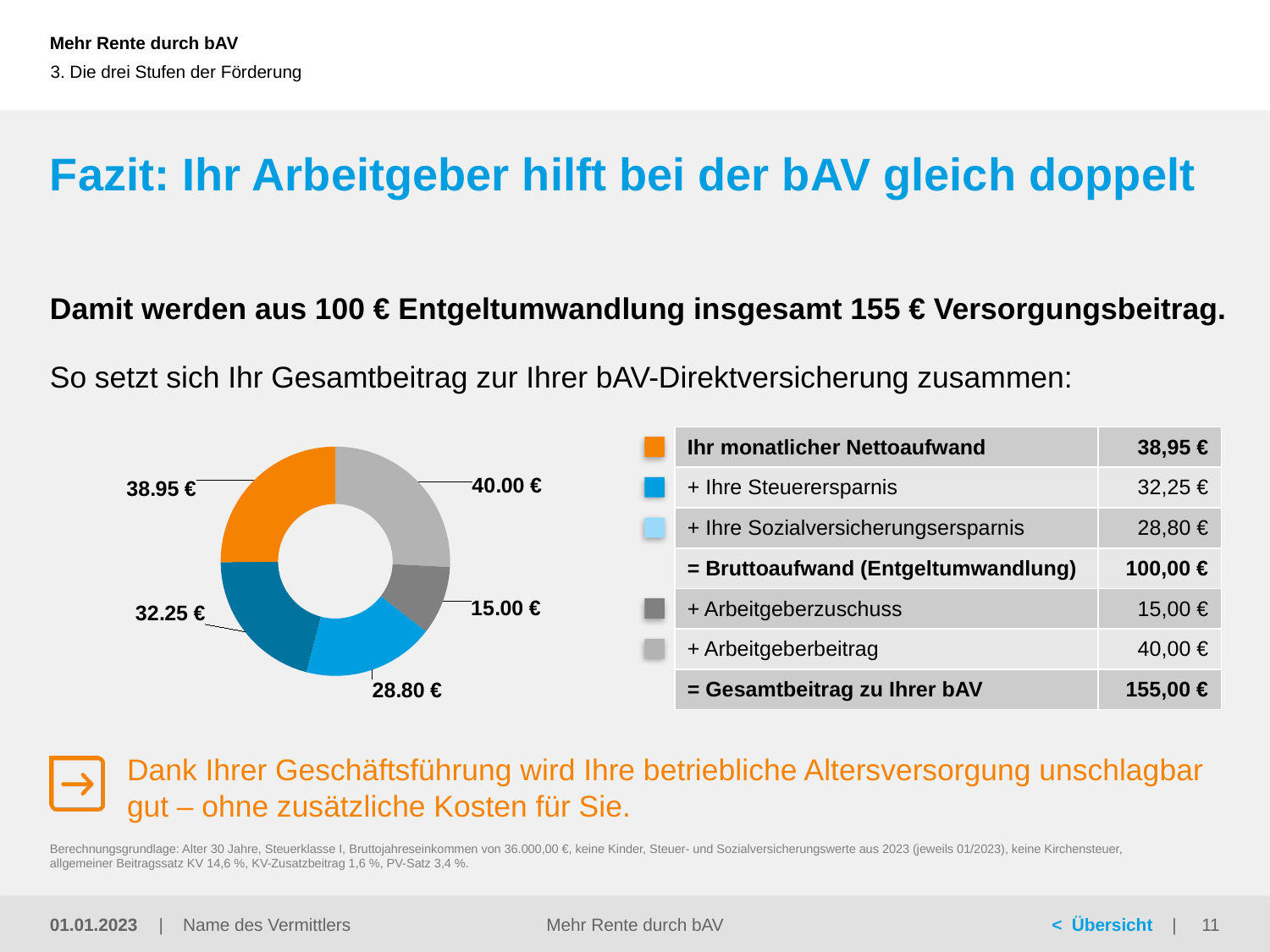
Which slice of the donut chart has the largest value? Arbeitgeberbeitrag (40.00 €) What colour is the slice representing Ihr monatlicher Nettoaufwand? Orange What value is shown for the Arbeitgeberbeitrag slice? 40.00 € Which is larger: the Nettoaufwand slice or the Steuerersparnis slice? Nettoaufwand (38.95 €) What value is shown for the Sozialversicherungsersparnis slice? 28.80 € What value is shown for the orange slice (Ihr monatlicher Nettoaufwand)? 38.95 € How many slices does the donut chart have? 5 Which slice of the donut chart has the smallest value? Arbeitgeberzuschuss (15.00 €) What is the difference between the Steuerersparnis slice and the Sozialversicherungsersparnis slice? 3.45 € What is the total of all slices in the donut chart (Gesamtbeitrag)? 155,00 € What kind of chart is shown on the slide? Donut (pie) chart What value is shown for the Arbeitgeberzuschuss slice? 15.00 €